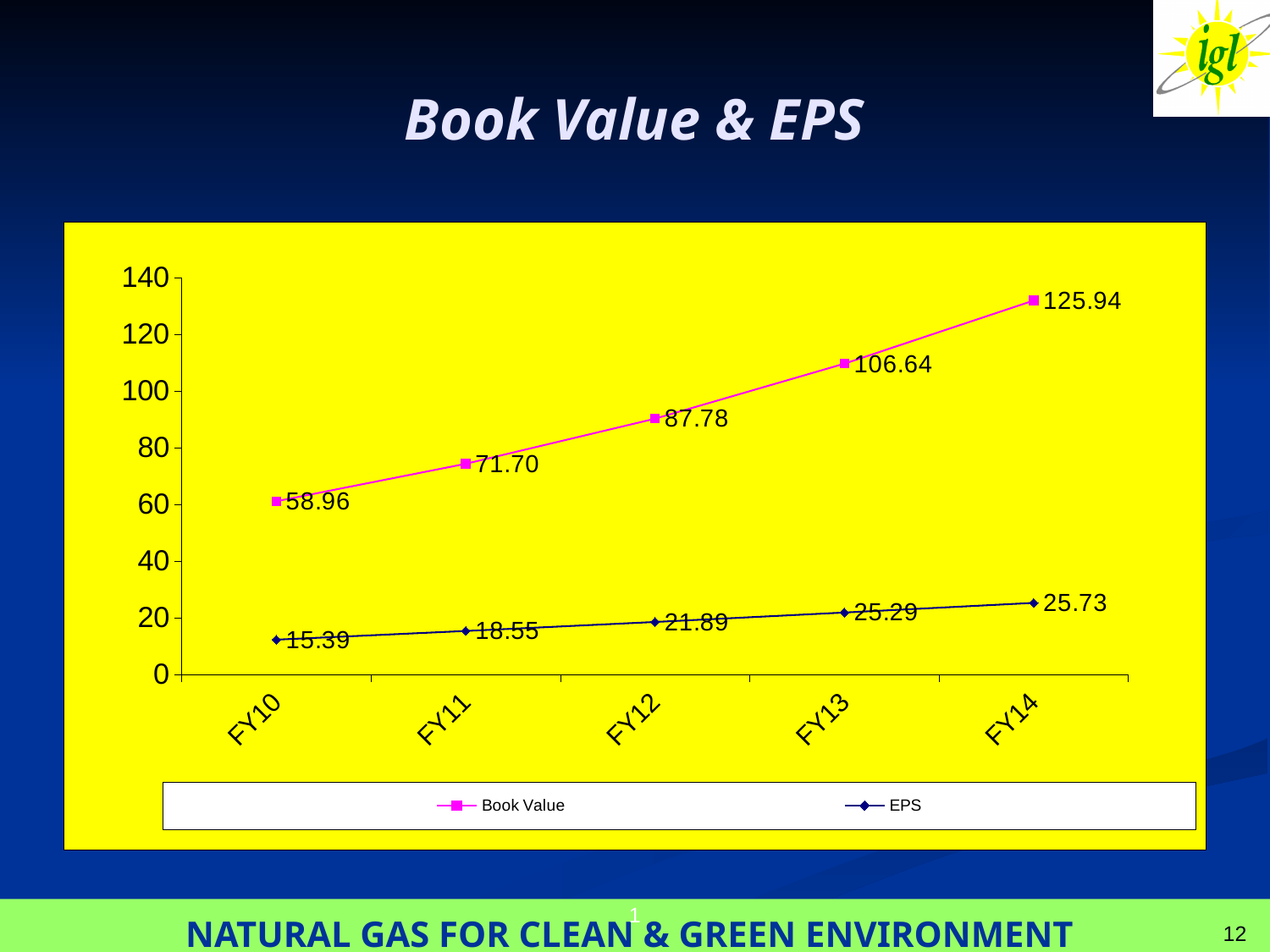
Does the Book Value rise or fall from FY10 to FY14? Rise In which fiscal year is the EPS lowest? FY10 What is the EPS for FY10? 15.39 What is the difference between the Book Value in FY14 and FY13? 19.30 What is the EPS for FY13? 25.29 What is the Book Value for FY14? 125.94 What is the Book Value for FY12? 87.78 How many series does the legend list? 2 How many fiscal years are shown on the x axis? 5 What kind of chart is shown on the slide? Line chart In which fiscal year is the Book Value highest? FY14 Which is larger, the EPS in FY12 or the EPS in FY11? EPS in FY12